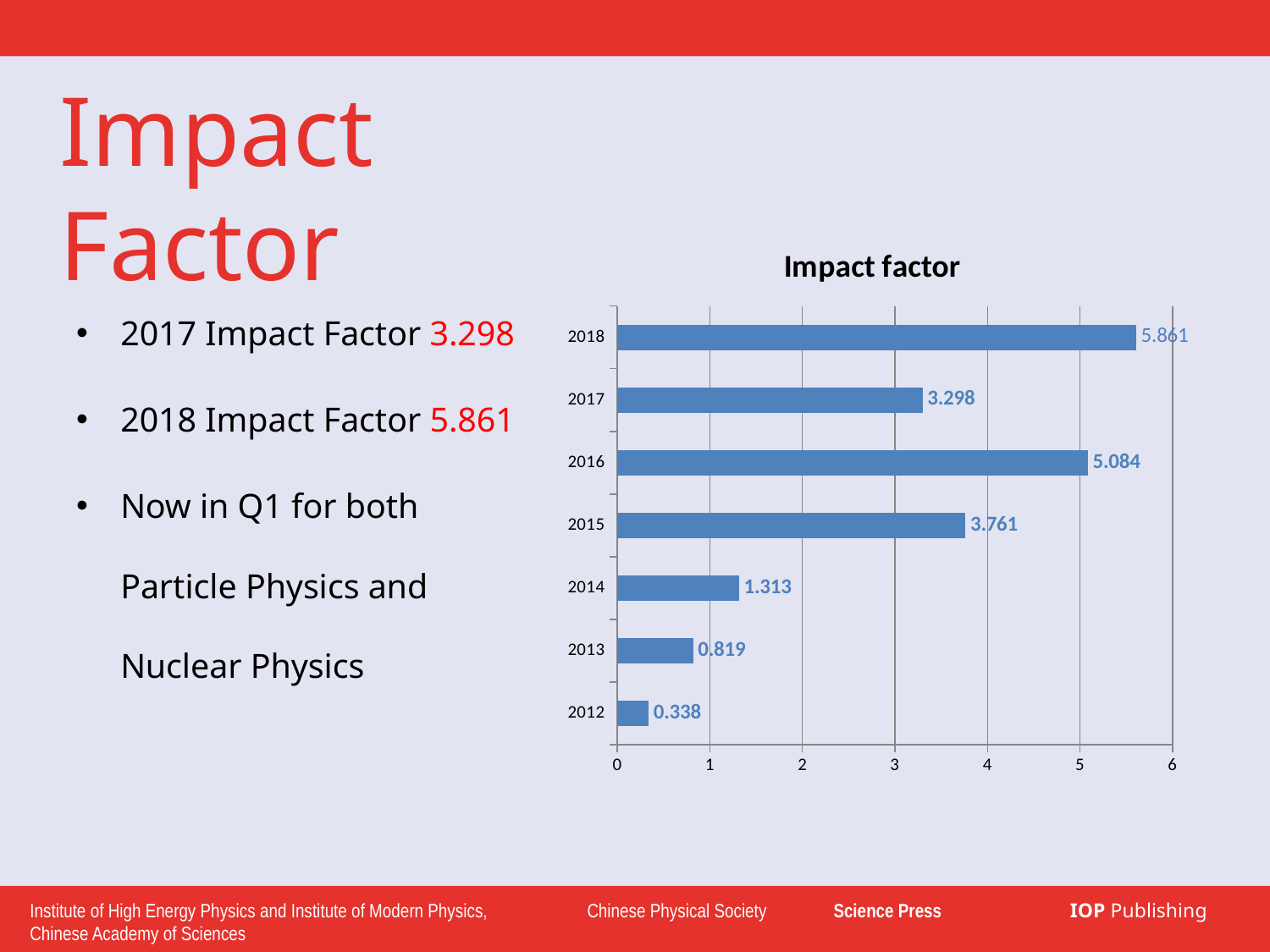
What is the difference between the impact factor in 2018 and in 2017? 2.563 Is the impact factor for 2015 greater or less than 3? greater Which year has the highest impact factor? 2018 Which year has a larger impact factor, 2016 or 2017? 2016 How many years are shown in the chart? 7 What is the impact factor for 2014? 1.313 Which year has the lowest impact factor? 2012 What is the difference between the impact factor in 2016 and in 2015? 1.323 What is the impact factor for 2012? 0.338 What is the impact factor for 2018? 5.861 What kind of chart is shown on the slide? bar chart What is the title of the chart? Impact factor